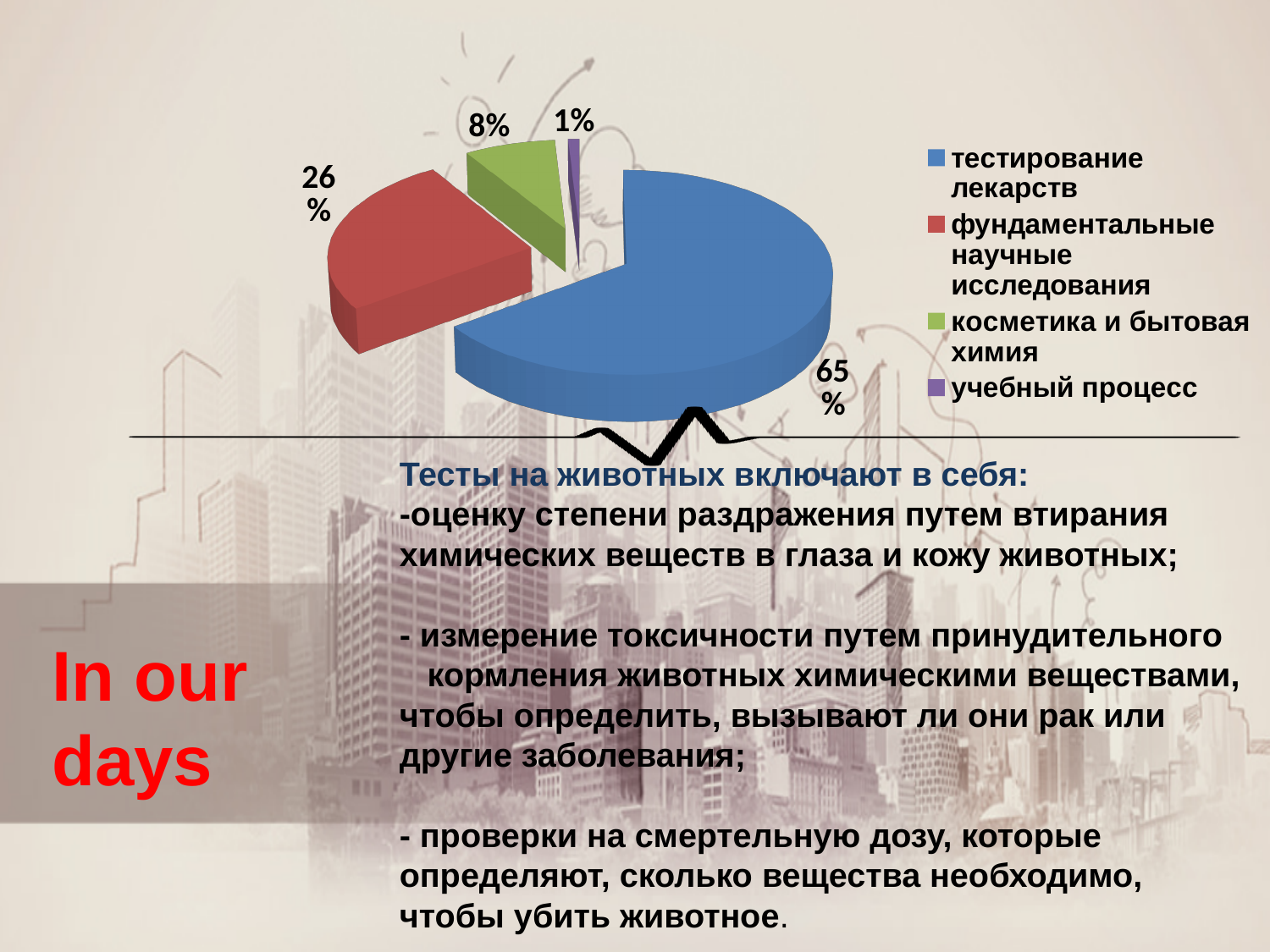
Which category has the smallest slice of the pie? учебный процесс What kind of chart is shown on the slide? pie chart What share of the pie does "фундаментальные научные исследования" take? 26% Which is larger: the slice for "косметика и бытовая химия" or the slice for "учебный процесс"? косметика и бытовая химия Which category has the largest slice of the pie? тестирование лекарств What share of the pie does "косметика и бытовая химия" take? 8% How many entries does the legend list? 4 What share of the pie does "тестирование лекарств" take? 65% What colour is the slice for "фундаментальные научные исследования"? red What is the difference in percentage points between "тестирование лекарств" and "фундаментальные научные исследования"? 39 How many categories does the pie chart show? 4